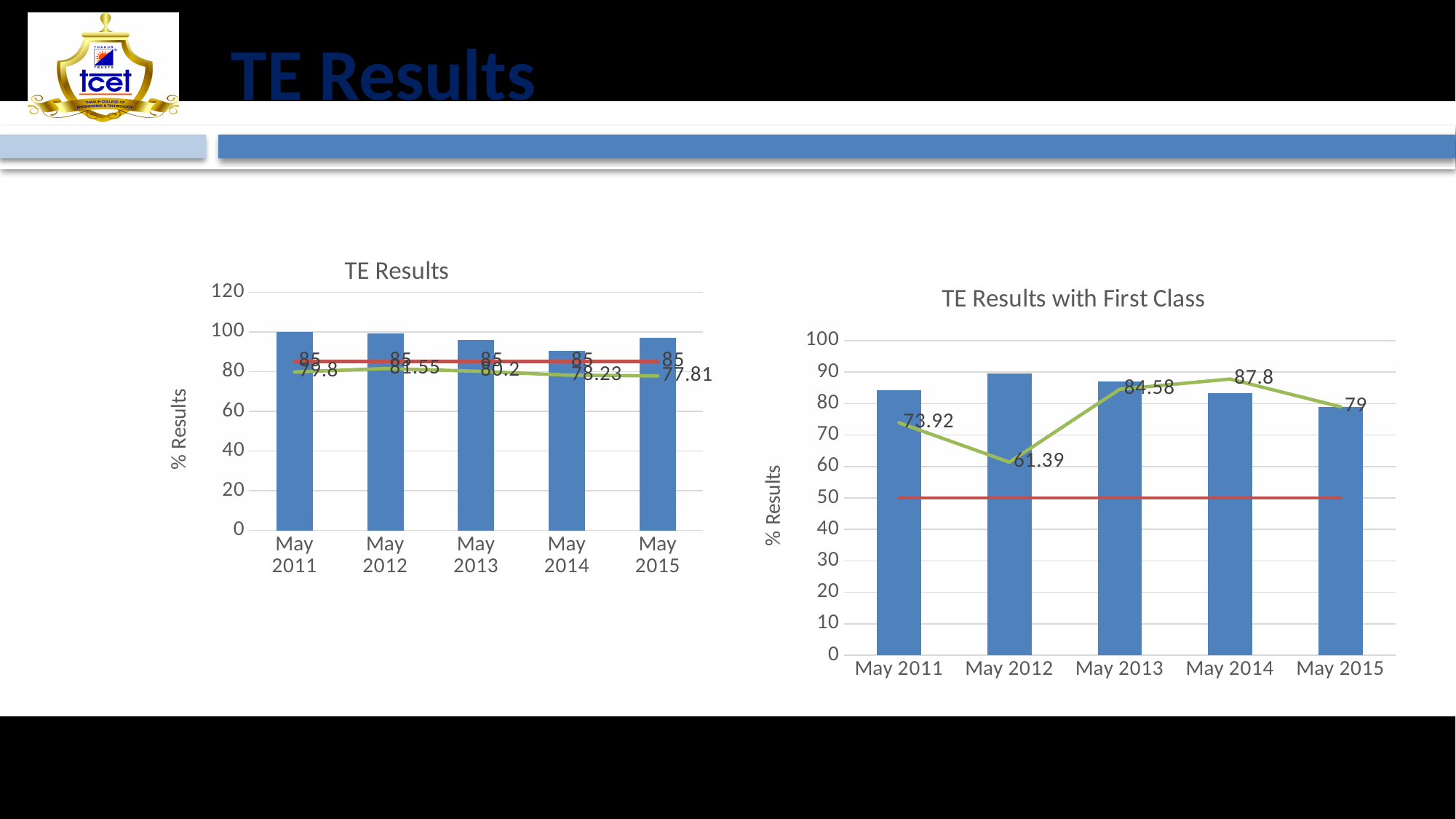
In the 'TE Results' chart, what is the difference between the green line values for May 2012 and May 2015? 3.74 In the 'TE Results with First Class' chart, which year has the lowest value on the green line? May 2012 In the 'TE Results with First Class' chart, is the bar for May 2012 greater or less than 80? greater In the 'TE Results with First Class' chart, what is the difference between the green line values for May 2014 and May 2012? 26.41 In the 'TE Results' chart, which year has the lowest value on the green line? May 2015 In the 'TE Results with First Class' chart, what value does the green line show for May 2013? 84.58 In the 'TE Results' chart, is the bar for May 2014 greater or less than 100? less In the 'TE Results' chart, what value is labelled on the red horizontal line? 85 In the 'TE Results' chart, which year has the highest value on the green line? May 2012 In the 'TE Results' chart, what value does the green line show for May 2012? 81.55 How many years are shown on the x axis of the 'TE Results with First Class' chart? 5 In the 'TE Results with First Class' chart, which year has the highest value on the green line? May 2014